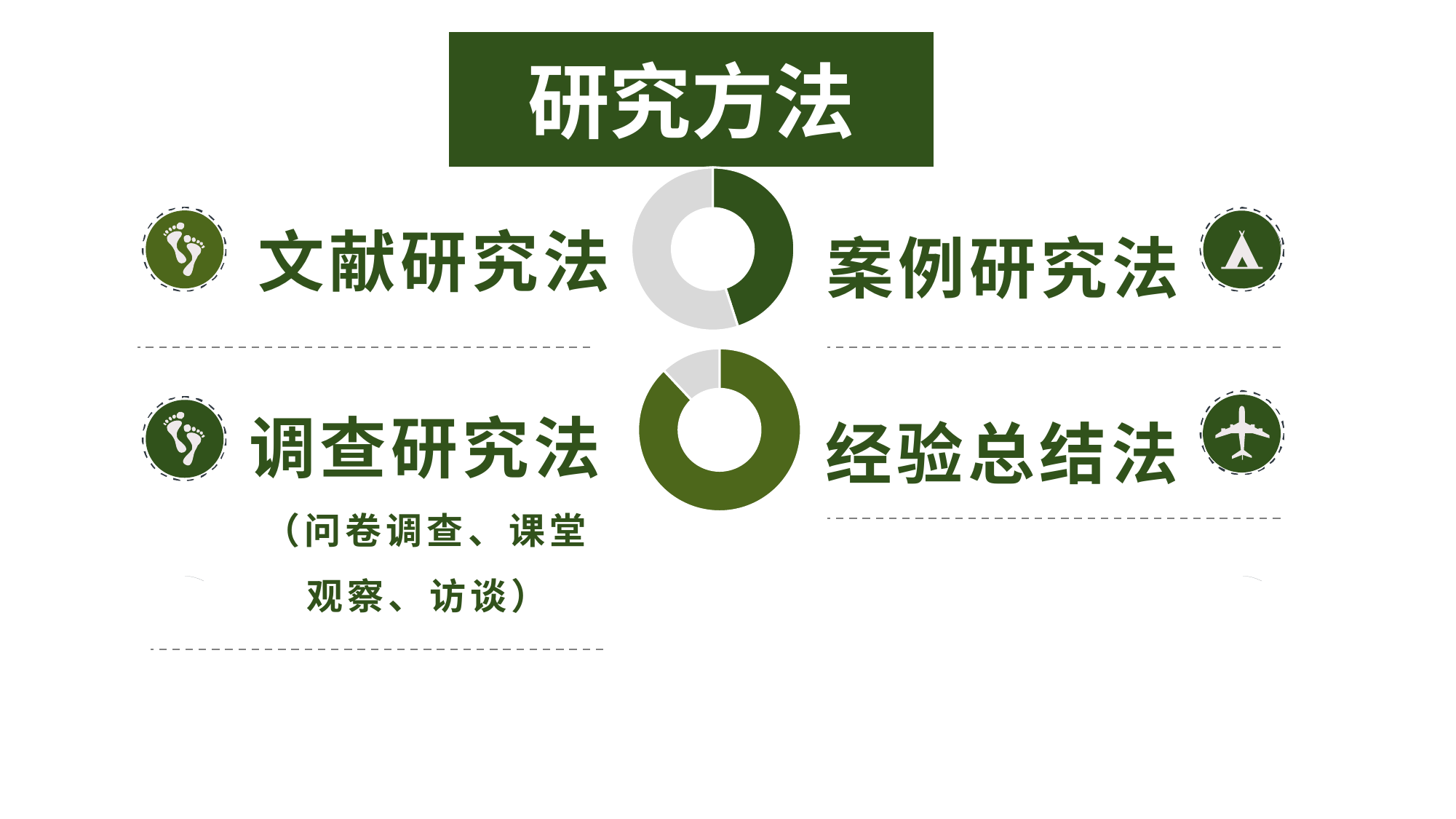
What two colours are used for the slices of the upper doughnut chart? Dark green and grey In the lower doughnut chart, is the green slice more or less than half of the ring? More Does either doughnut chart display a legend? No What kind of chart is the upper chart in the centre of the slide? Doughnut chart In the upper doughnut chart, how many slices are there? 2 What kind of chart is the lower chart in the centre of the slide? Doughnut chart In the lower doughnut chart, how many slices are there? 2 In the upper doughnut chart, which slice is larger, the green one or the grey one? The grey one In the upper doughnut chart, is the green slice more or less than half of the ring? Less How many charts are shown on the slide? 2 In the lower doughnut chart, which slice is larger, the green one or the grey one? The green one